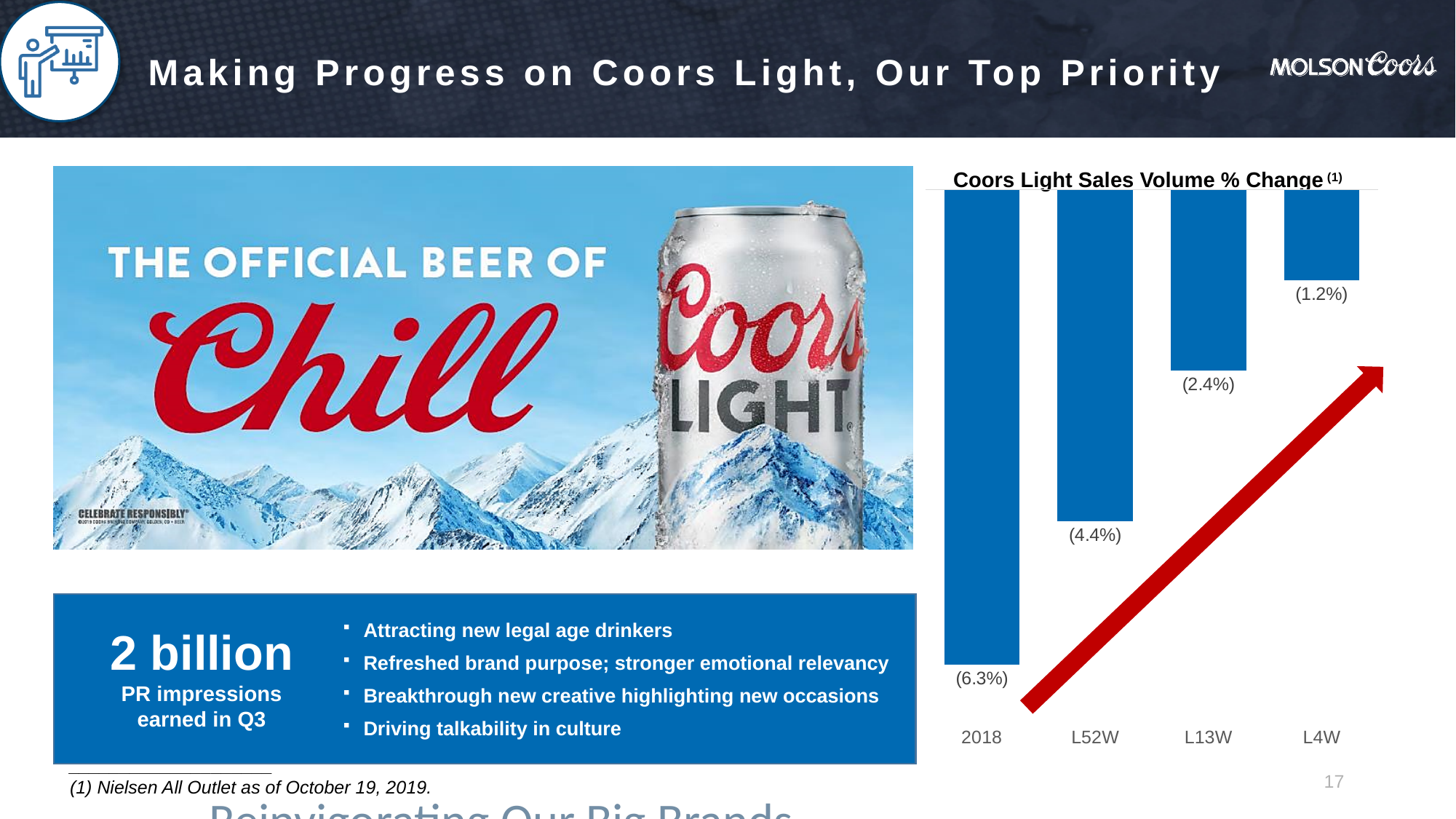
What is the value shown for L13W in the Coors Light Sales Volume % Change chart? (2.4%) How many periods are shown on the x axis of the Coors Light Sales Volume % Change chart? 4 Which period has a larger sales volume decline, L52W or L13W? L52W What is the value shown for L4W in the Coors Light Sales Volume % Change chart? (1.2%) What is the value shown for 2018 in the Coors Light Sales Volume % Change chart? (6.3%) By how many percentage points does the decline for L52W exceed the decline for L13W in the Coors Light Sales Volume % Change chart? 2.0 percentage points Which period shows the largest sales volume decline in the Coors Light Sales Volume % Change chart? 2018 Which period shows the smallest sales volume decline in the Coors Light Sales Volume % Change chart? L4W Do the sales volume % change values rise or fall from 2018 to L4W in the Coors Light Sales Volume % Change chart? Rise By how many percentage points does the decline for 2018 exceed the decline for L4W in the Coors Light Sales Volume % Change chart? 5.1 percentage points What is the value shown for L52W in the Coors Light Sales Volume % Change chart? (4.4%) What kind of chart is the Coors Light Sales Volume % Change chart? Bar chart